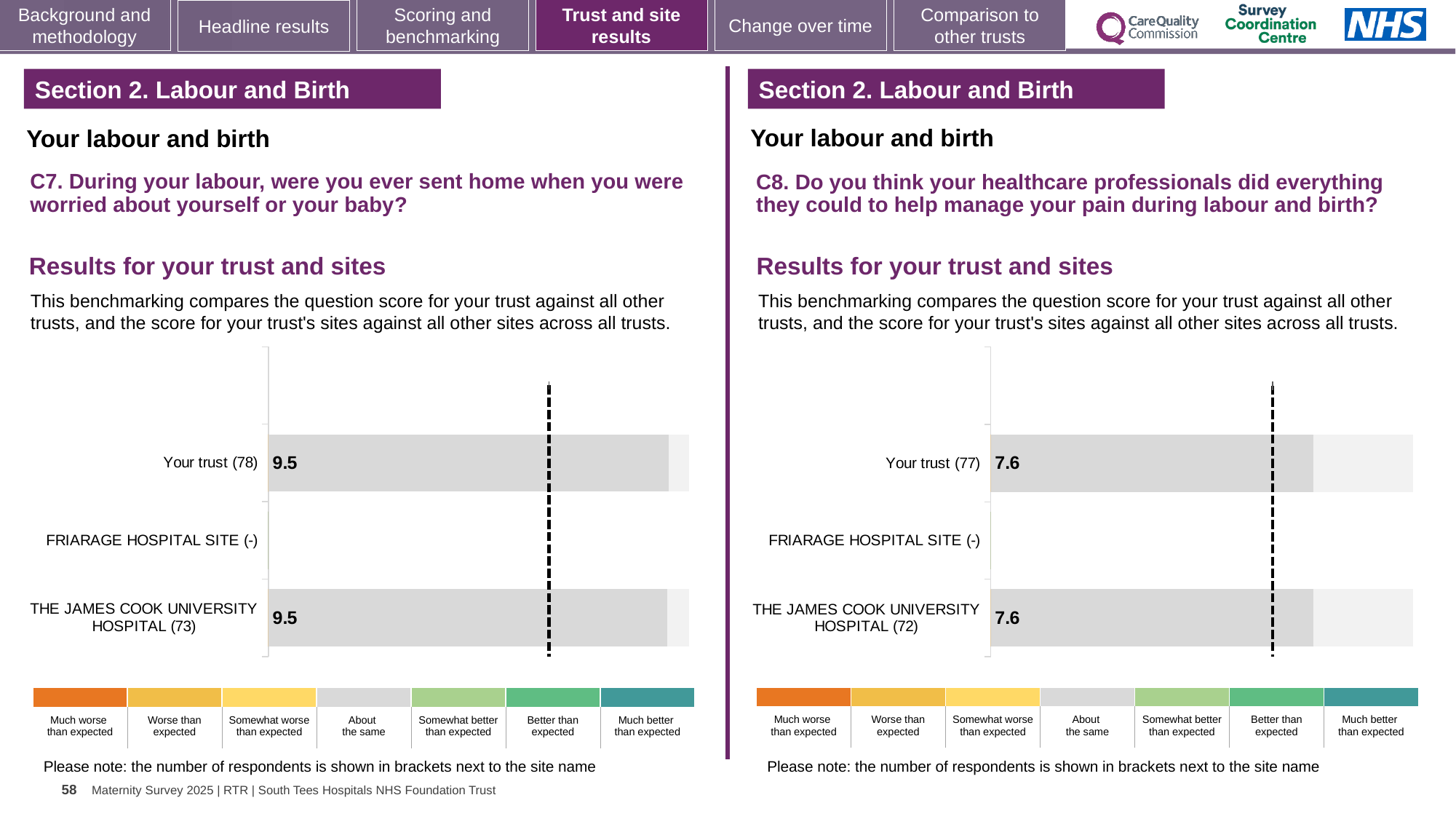
What kind of chart is used in the C7 chart on the left? Bar chart How many categories (rows) are listed in the C8 chart on the right? 3 In the C8 chart on the right, what is the score for THE JAMES COOK UNIVERSITY HOSPITAL (72)? 7.6 In the C7 chart on the left, what is the score for Your trust (78)? 9.5 Is the score for Your trust in the C7 chart on the left larger or smaller than the score for Your trust in the C8 chart on the right? Larger In the C7 chart on the left, what is the score for THE JAMES COOK UNIVERSITY HOSPITAL (73)? 9.5 In the C8 chart on the right, what is the difference between the score for Your trust and the score for THE JAMES COOK UNIVERSITY HOSPITAL? 0 In the C8 chart on the right, what is the score for Your trust (77)? 7.6 In the C7 chart on the left, which site has no bar plotted? FRIARAGE HOSPITAL SITE (-) In the C7 chart on the left, what is the difference between the score for Your trust and the score for THE JAMES COOK UNIVERSITY HOSPITAL? 0 How many categories (rows) are listed in the C7 chart on the left? 3 How many respondents are shown in brackets for Your trust in the C8 chart on the right? 77